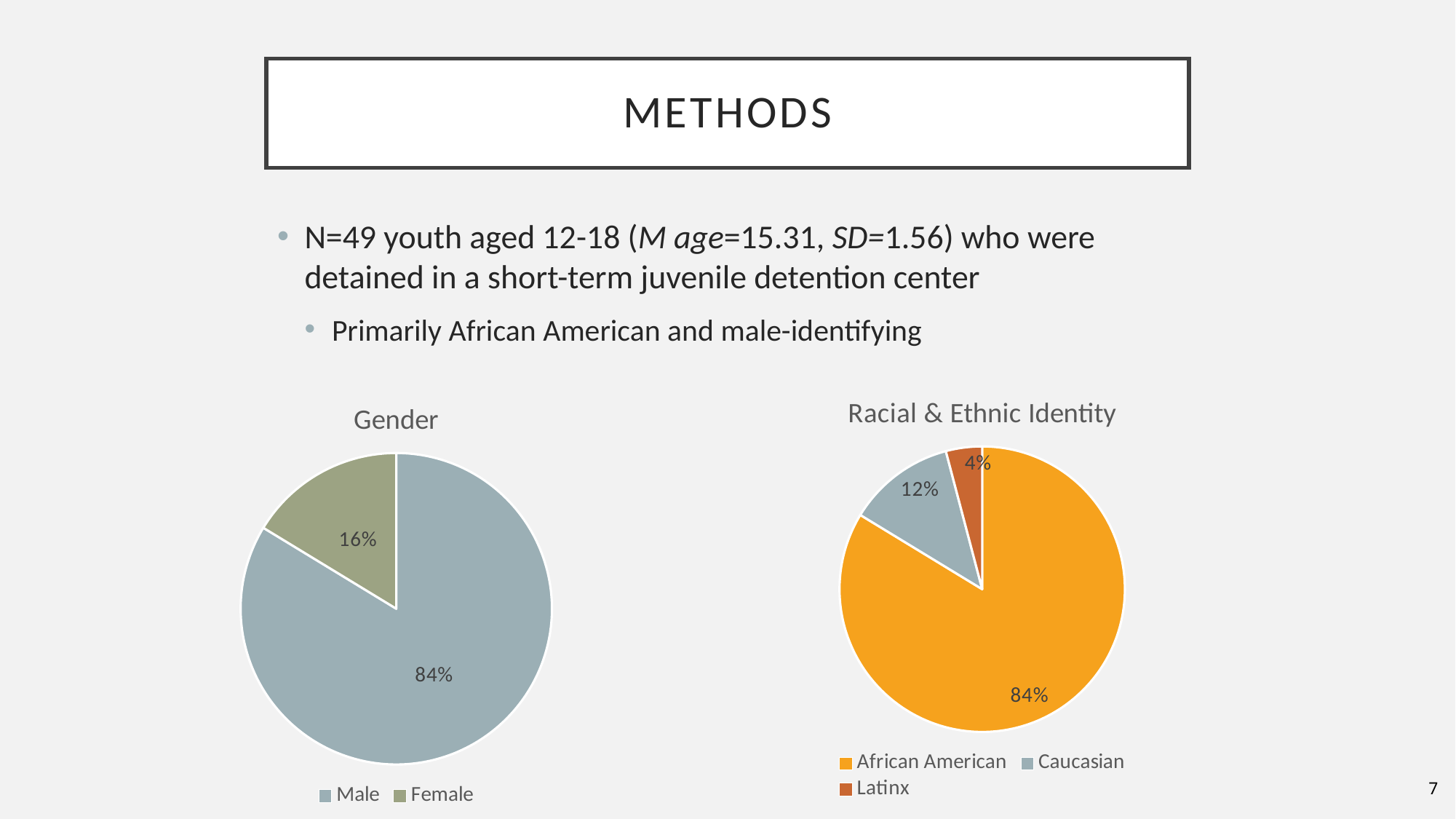
In the Racial & Ethnic Identity chart, which is larger, Caucasian or Latinx? Caucasian What type of chart is the Gender chart? Pie chart In the Racial & Ethnic Identity chart, what percentage is Caucasian? 12% In the Gender chart, what is the difference between the Male and Female percentages? 68% In the Gender chart, what percentage is Male? 84% In the Gender chart, what percentage is Female? 16% How many categories does the Racial & Ethnic Identity chart show? 3 In the Racial & Ethnic Identity chart, which category has the largest share? African American In the Racial & Ethnic Identity chart, what percentage is Latinx? 4% How many entries does the legend of the Gender chart list? 2 In the Racial & Ethnic Identity chart, what is the difference between the Caucasian and Latinx percentages? 8% In the Racial & Ethnic Identity chart, which category has the smallest share? Latinx